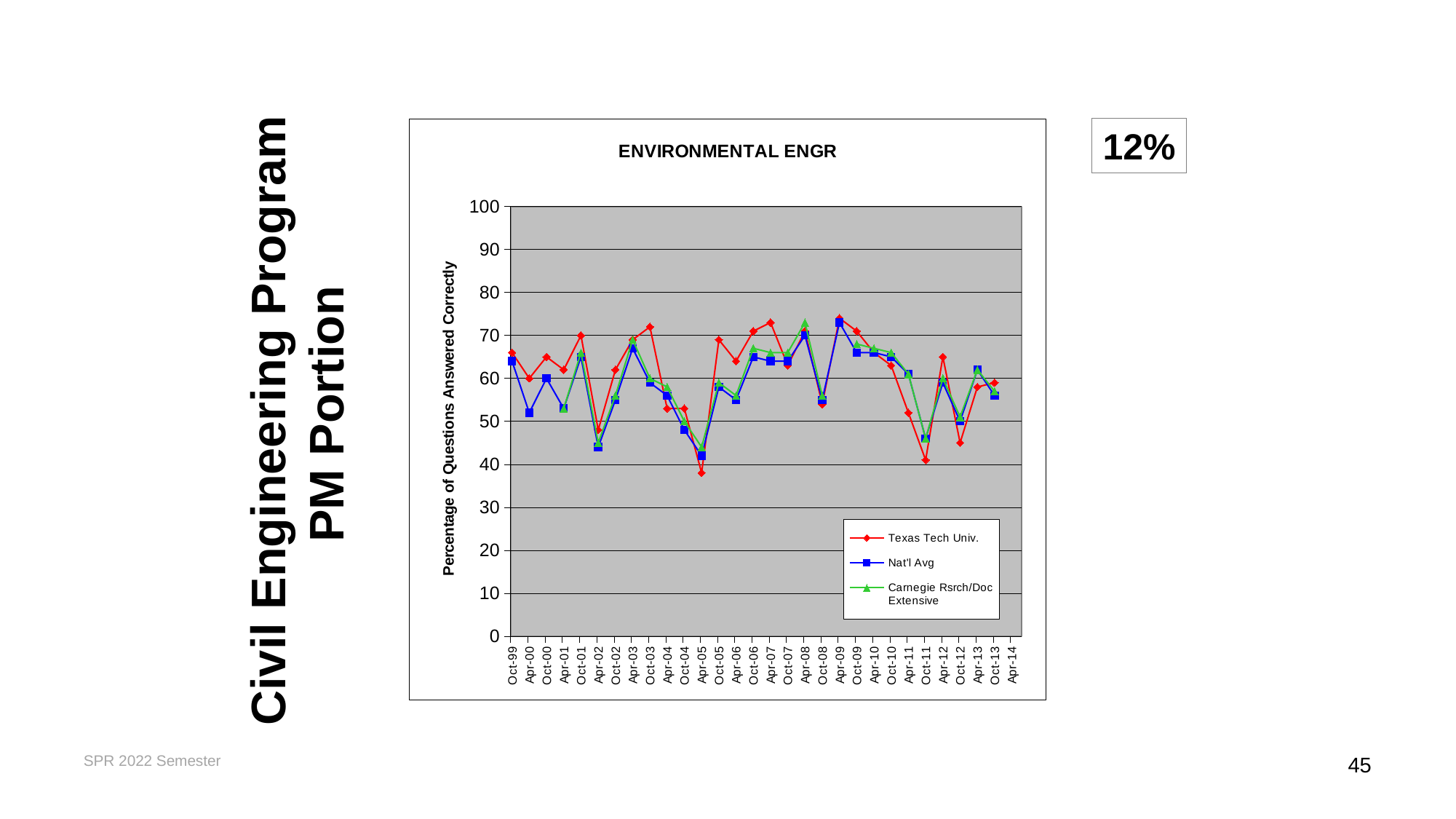
At Apr-05, which is larger: the value for Texas Tech Univ. or the value for Nat'l Avg? Nat'l Avg At Apr-00, which is larger: the value for Texas Tech Univ. or the value for Nat'l Avg? Texas Tech Univ. Is the value for Texas Tech Univ. at Oct-11 greater or less than 50? less Is the value for Nat'l Avg at Apr-02 greater or less than 50? less What is the label on the vertical axis of the chart? Percentage of Questions Answered Correctly Is the value for Texas Tech Univ. at Oct-12 greater or less than 50? less Does the Texas Tech Univ. series rise or fall from Oct-09 to Oct-11? Fall What kind of chart is shown on the slide? Line chart How many series does the legend of the chart list? 3 What is the title of the chart? ENVIRONMENTAL ENGR